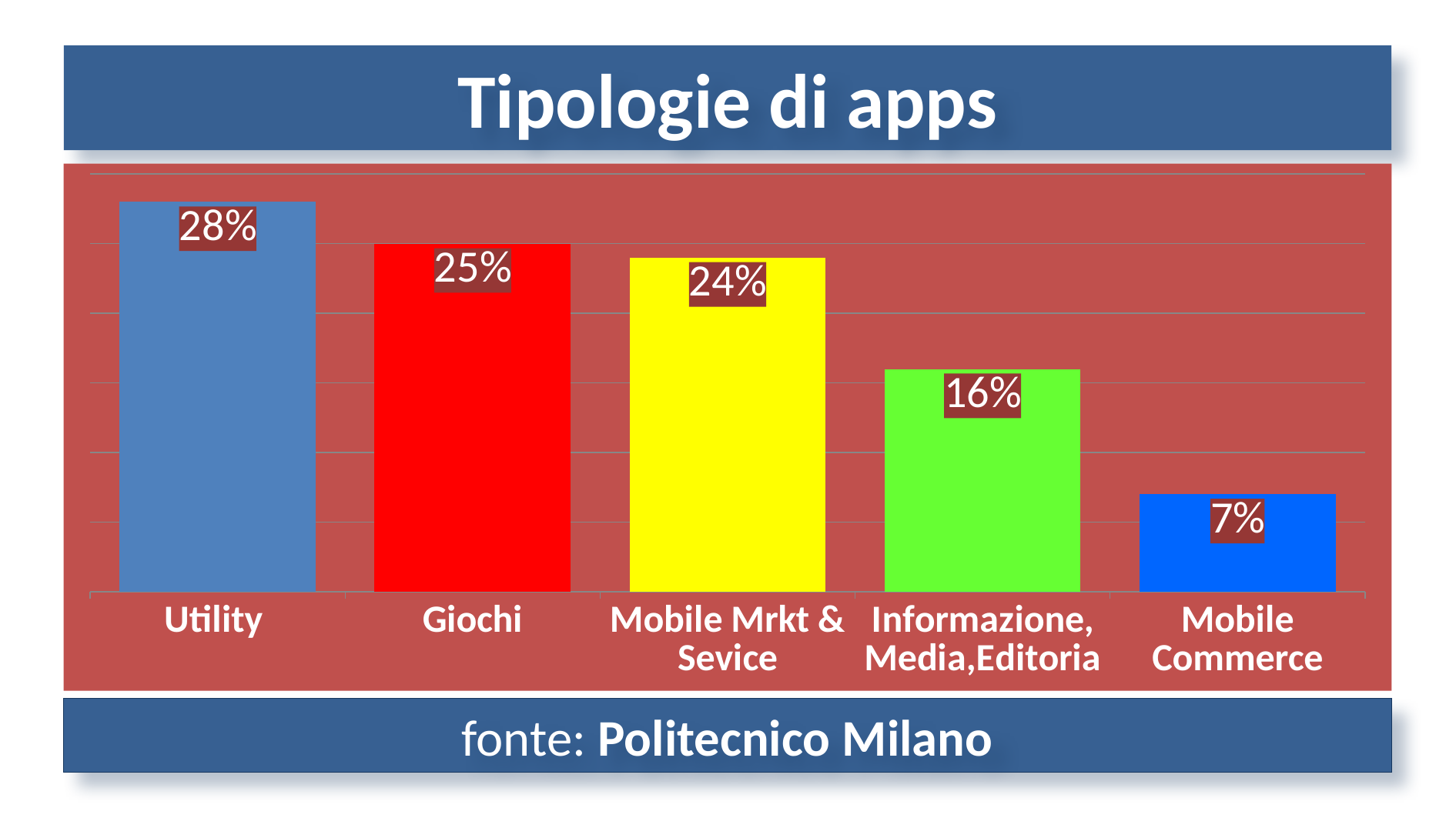
What is the value for Giochi? 25% What is the value for Informazione, Media,Editoria? 16% What is the value for Mobile Mrkt & Sevice? 24% What is the value for Mobile Commerce? 7% What is the value for Utility? 28% Which category has the highest value? Utility What kind of chart is shown on the slide? Bar chart Which is larger, the value for Giochi or the value for Informazione, Media,Editoria? Giochi What is the difference between the values for Giochi and Informazione, Media,Editoria? 9% What is the difference between the values for Utility and Mobile Commerce? 21% How many categories are shown in the chart? 5 Which category has the lowest value? Mobile Commerce